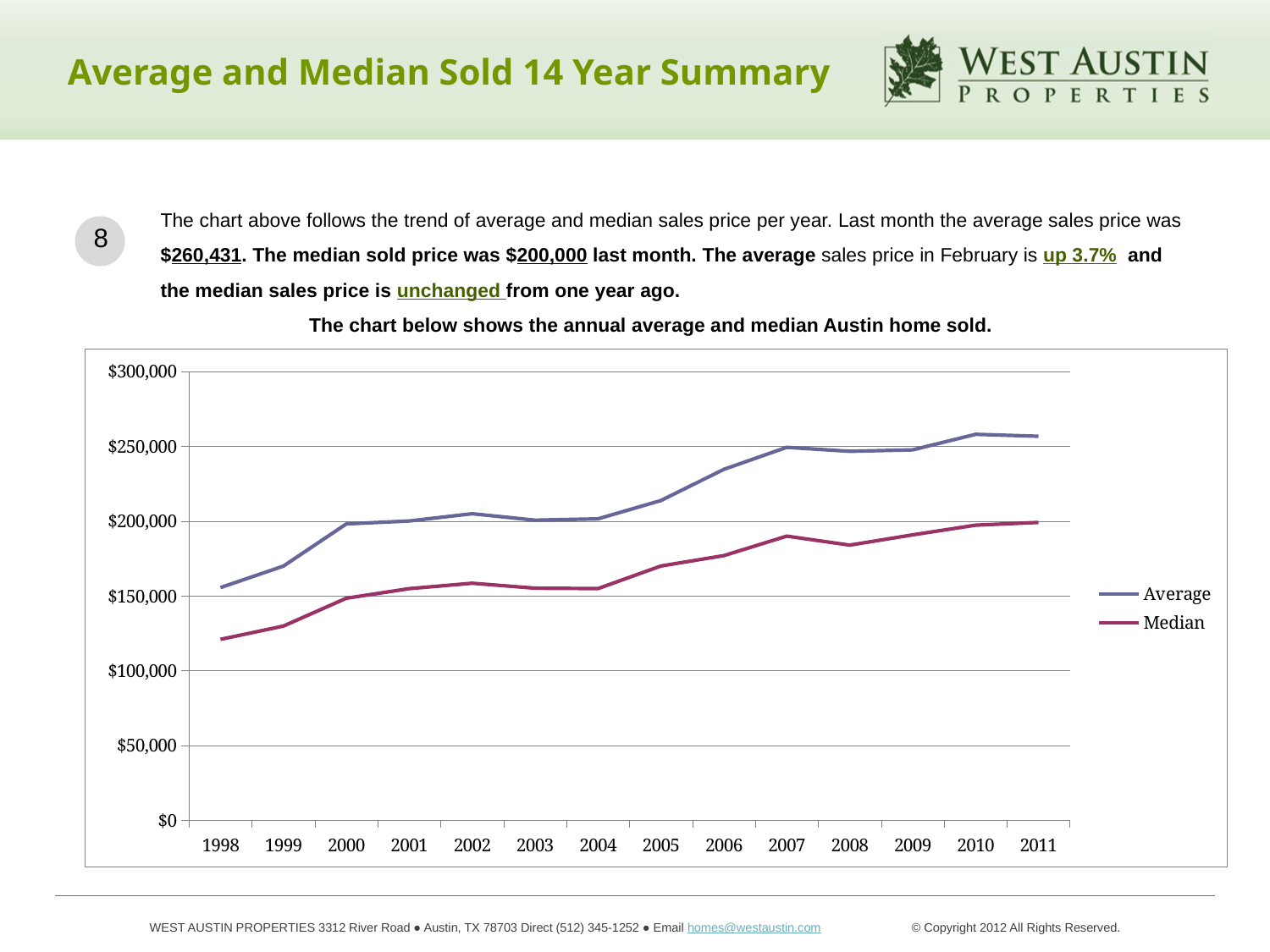
Does the Average series generally rise or fall from 1998 to 2011? Rise How many series does the chart legend list? 2 In which year is the Median series at its lowest? 1998 What kind of chart is shown on the slide? Line chart Is the Median value for 2007 greater or less than $150,000? greater Does the Median series generally rise or fall from 1998 to 2011? Rise How many years are plotted along the x axis of the chart? 14 In 2005, which series has the larger value, Average or Median? Average Is the Average value for 1998 greater or less than $200,000? less In which year is the Average series at its lowest? 1998 Which two series are listed in the chart legend? Average and Median Which year is the first on the x axis of the chart? 1998